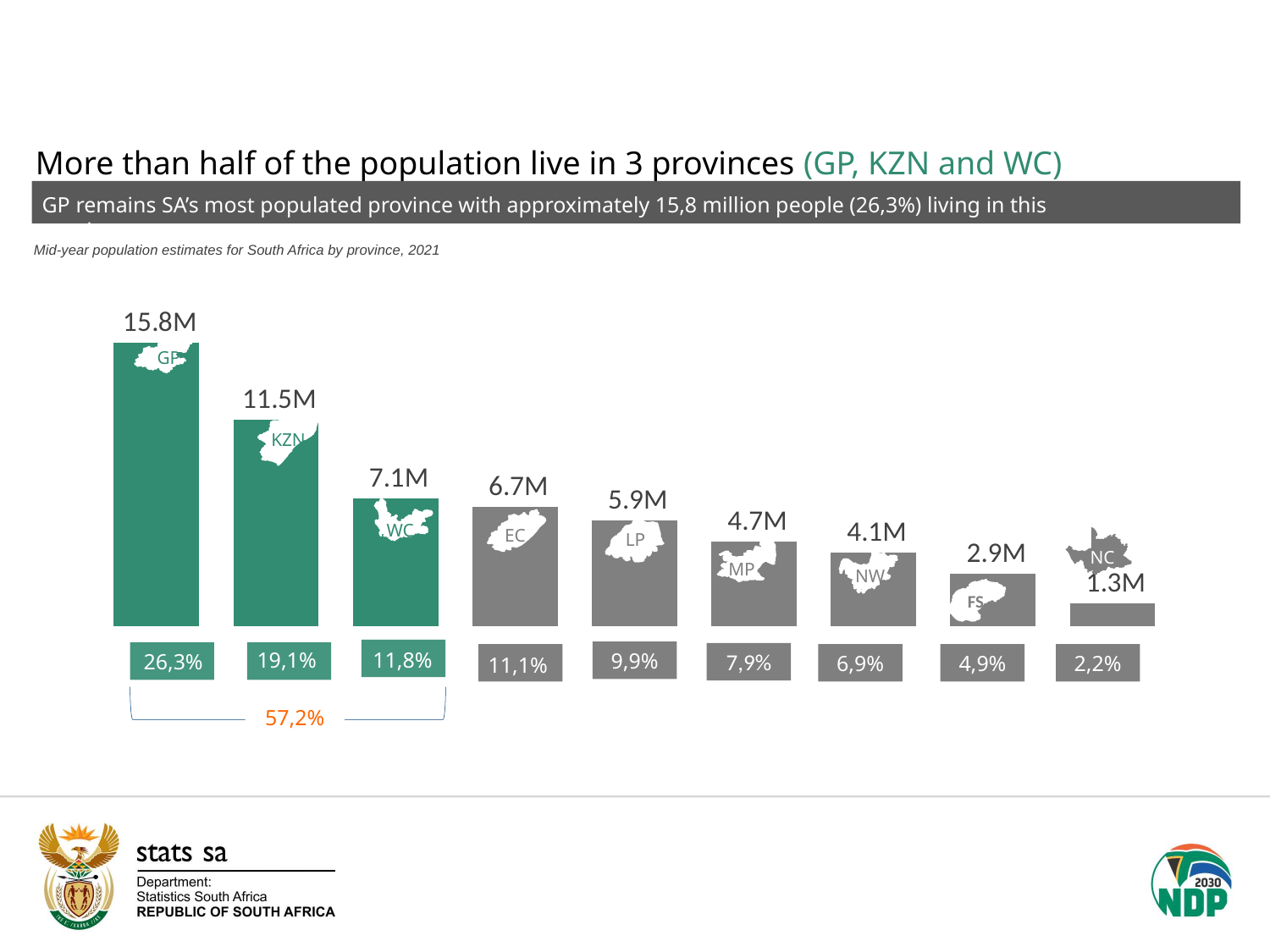
Which province has the highest population in the chart? GP What type of chart is shown on the slide? Bar chart What is the difference in percentage share between WC and EC? 0,7% Which province has the lowest population in the chart? NC Which has a larger population, LP or MP? LP What combined percentage is shown for the three green bars (GP, KZN and WC)? 57,2% How many provinces are shown in the chart? 9 What percentage share is shown for FS? 4,9% What is the difference in population between GP and KZN? 4.3M What is the population value shown for GP? 15.8M What percentage share is shown for KZN? 19,1% What is the population value shown for EC? 6.7M